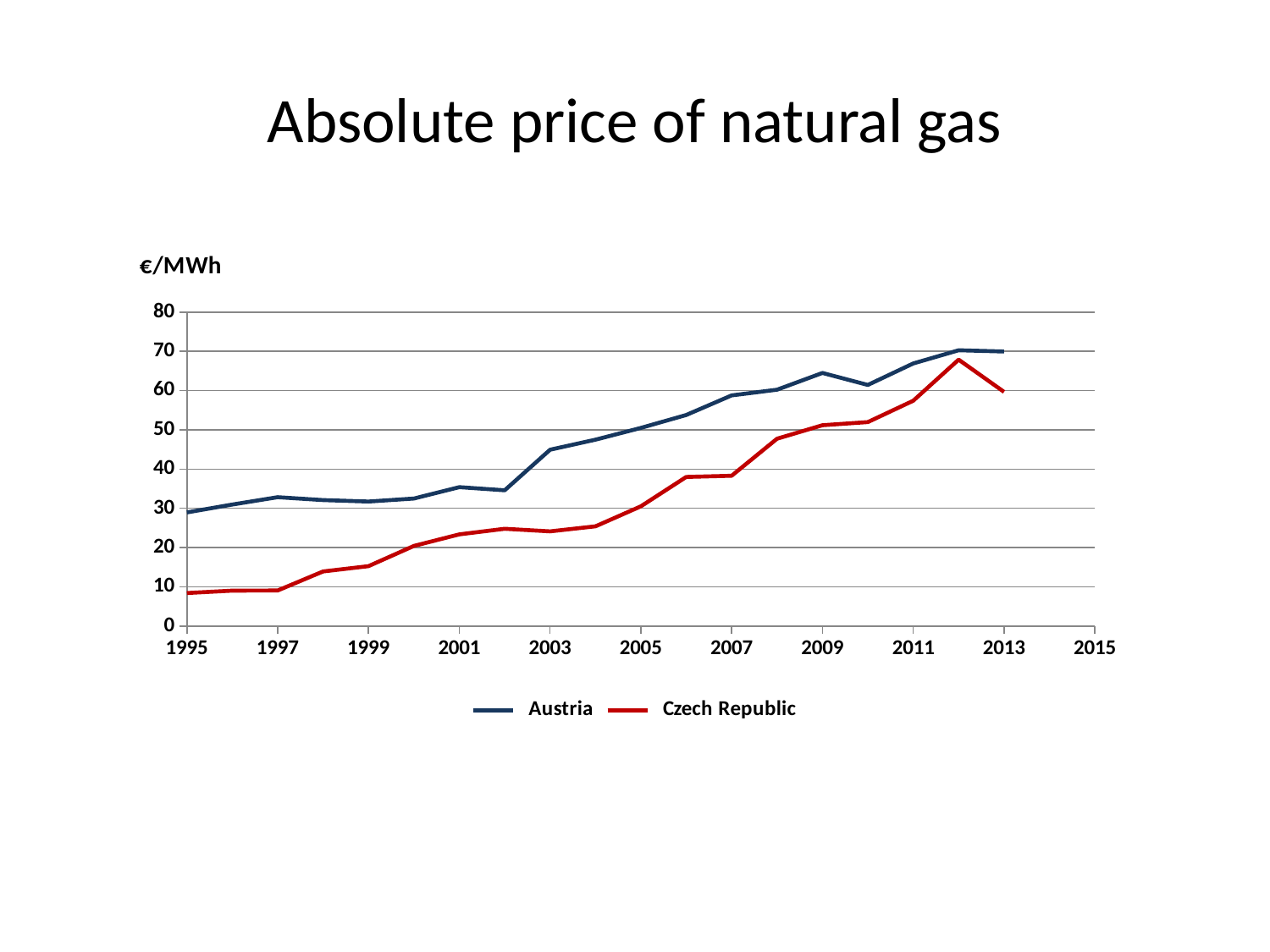
Is the value for Austria in 2013 greater or less than 60? greater In 2005, which series has the higher value, Austria or Czech Republic? Austria Which two countries are shown in the legend? Austria and Czech Republic Does the Czech Republic line generally rise or fall from 1995 to 2011? rise What unit is shown on the y axis of the chart? €/MWh Is the value for Czech Republic in 2012 greater or less than 60? greater How many series does the legend list? 2 Does the Austria line generally rise or fall from 1995 to 2013? rise What kind of chart is shown on the slide? line chart In which year does the Czech Republic series reach its highest value? 2012 Is the value for Czech Republic in 1995 greater or less than 10? less